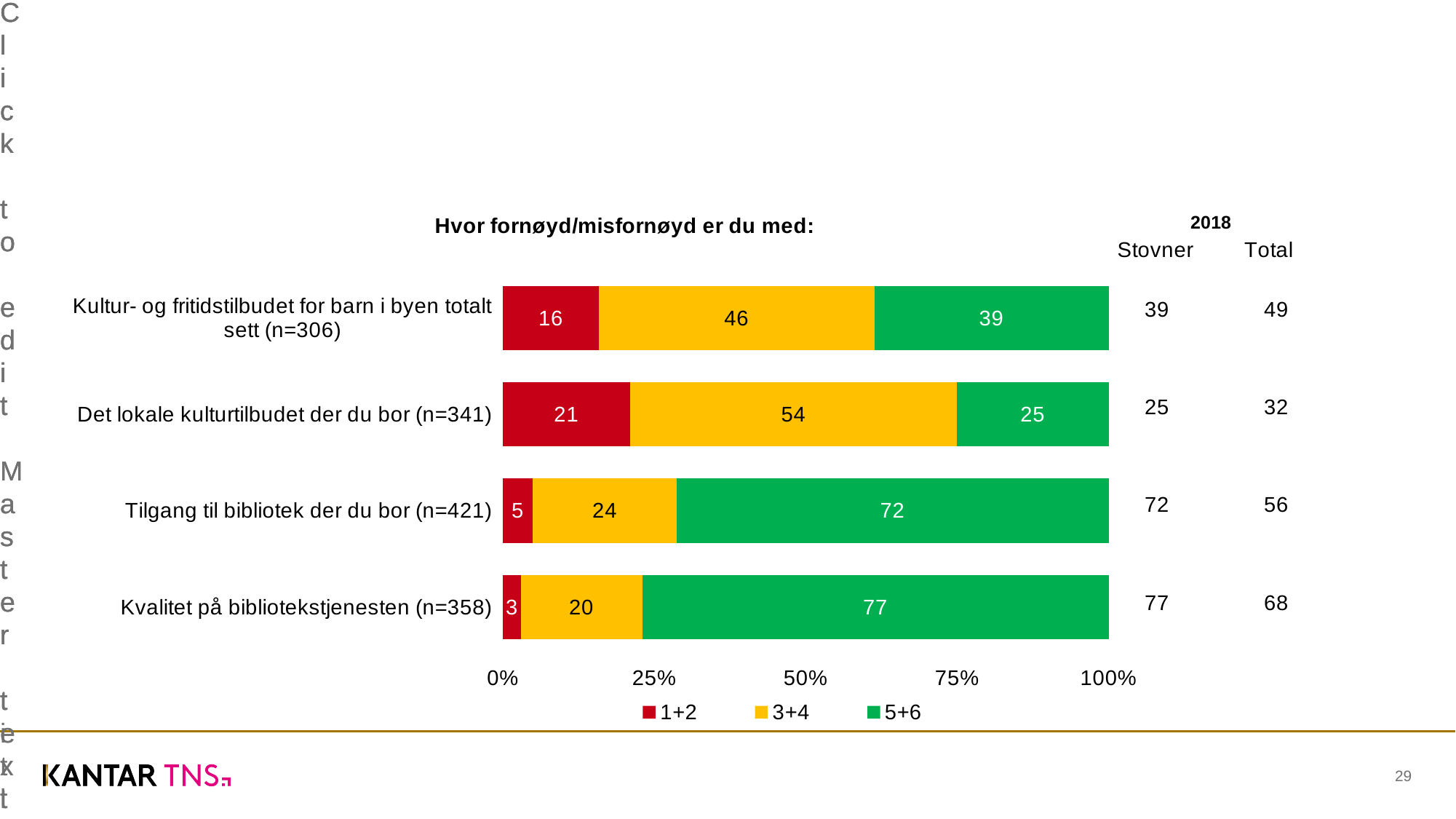
Which colour represents the 1+2 series in the chart? Red What is the 3+4 value for "Kultur- og fritidstilbudet for barn i byen totalt sett (n=306)"? 46 What is the difference between the 3+4 values for "Det lokale kulturtilbudet der du bor (n=341)" and "Kvalitet på bibliotekstjenesten (n=358)"? 34 What is the title of the chart? Hvor fornøyd/misfornøyd er du med: What kind of chart is shown on the slide? Stacked bar chart How many categories are plotted in the chart? 4 What is the 5+6 value for "Tilgang til bibliotek der du bor (n=421)"? 72 How many series does the legend list? 3 What is the 1+2 value for "Det lokale kulturtilbudet der du bor (n=341)"? 21 Which category has the highest 5+6 value? Kvalitet på bibliotekstjenesten (n=358) Which category has the lowest 1+2 value? Kvalitet på bibliotekstjenesten (n=358) Which is larger: the 5+6 value for "Kultur- og fritidstilbudet for barn i byen totalt sett (n=306)" or for "Det lokale kulturtilbudet der du bor (n=341)"? Kultur- og fritidstilbudet for barn i byen totalt sett (n=306)